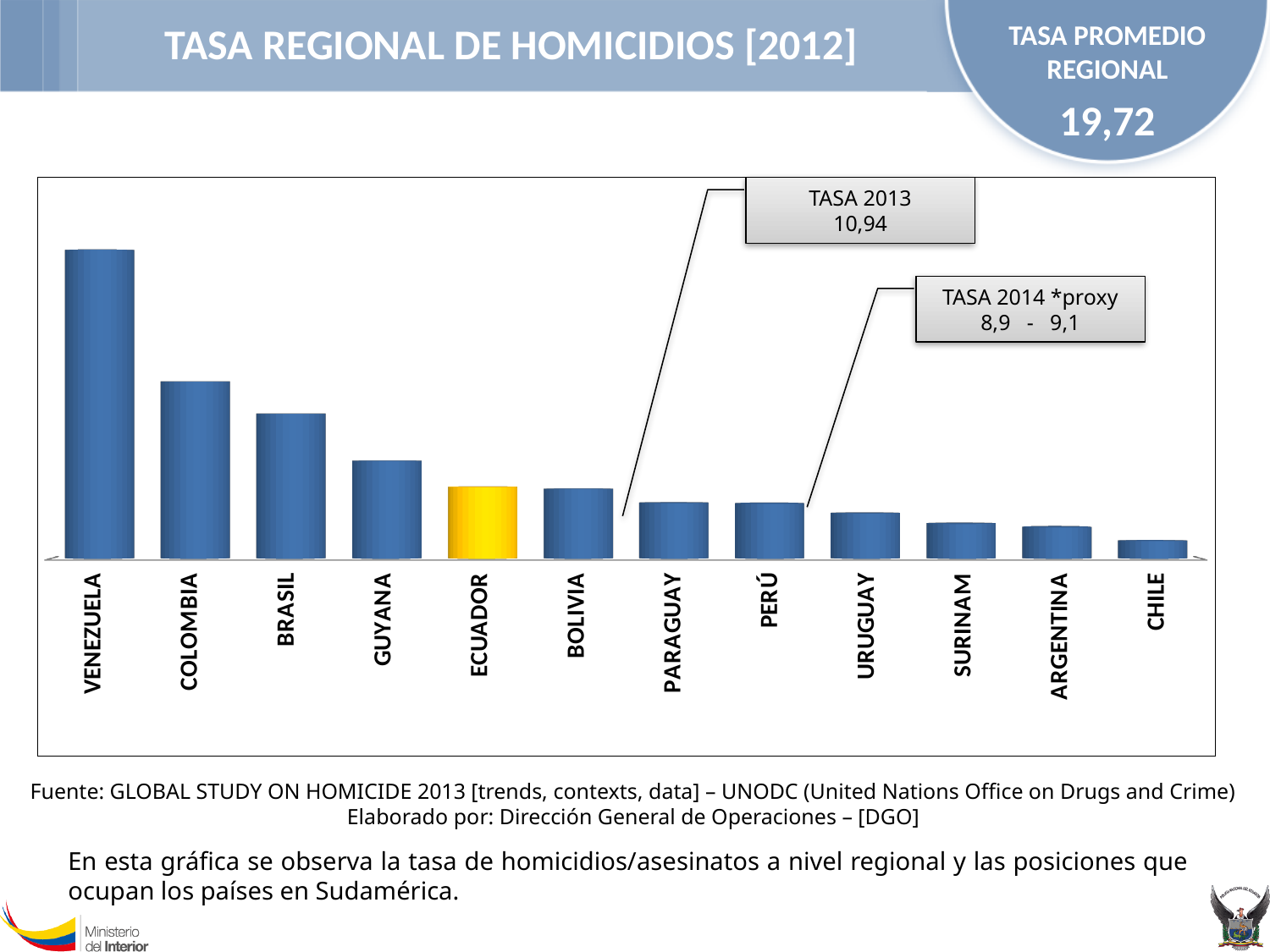
How many countries are shown in the chart? 12 Which has the larger value, ARGENTINA or CHILE? ARGENTINA Which country has the highest homicide rate in the chart? VENEZUELA Which has the larger value, VENEZUELA or COLOMBIA? VENEZUELA Do the bar values rise or fall from left to right across the chart? Fall Which country has the lowest homicide rate in the chart? CHILE What kind of chart is shown on the slide? Bar chart Which has the larger value, COLOMBIA or URUGUAY? COLOMBIA What is the title of the chart? TASA REGIONAL DE HOMICIDIOS [2012] Which country's bar is highlighted in yellow instead of blue? ECUADOR